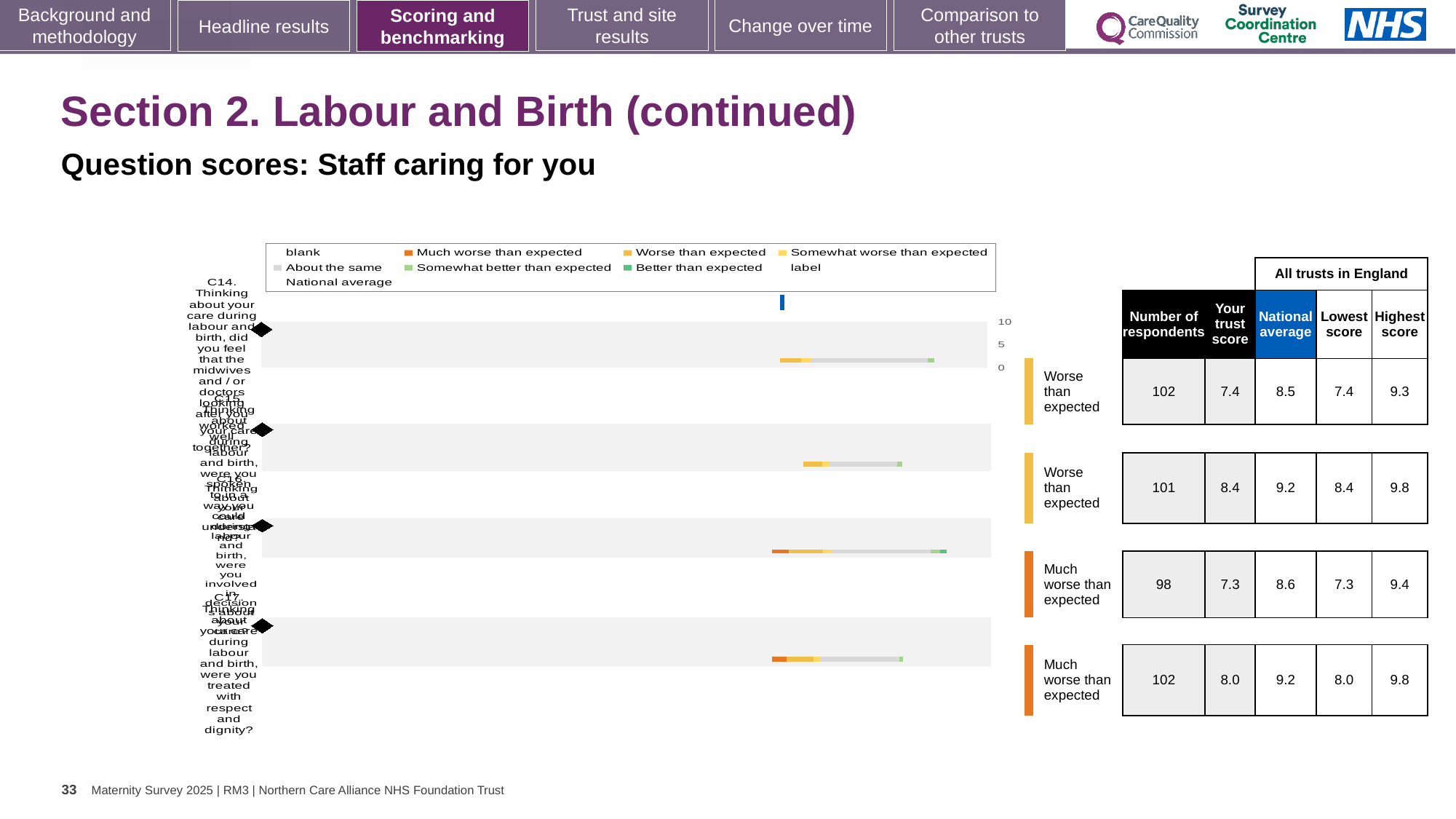
How many respondents answered question C17 (treated with respect and dignity)? 102 What is the highest score among all trusts in England for question C17 (treated with respect and dignity)? 9.8 What is the trust score for question C17 (treated with respect and dignity)? 8.0 What benchmark category is shown for question C14 (midwives and/or doctors worked well together)? Worse than expected What benchmark category is shown for question C17 (treated with respect and dignity)? Much worse than expected What kind of chart is shown on the slide? bar chart What is the lowest number of respondents shown for any question on the slide? 98 What is the national average for question C14 (midwives and/or doctors worked well together)? 8.5 What is the trust score for question C14 (midwives and/or doctors worked well together)? 7.4 What is the difference between the national average and the trust score for question C14? 1.1 Which has the larger trust score, question C14 or question C17? C17 How many questions (rows) are plotted in the chart? 4